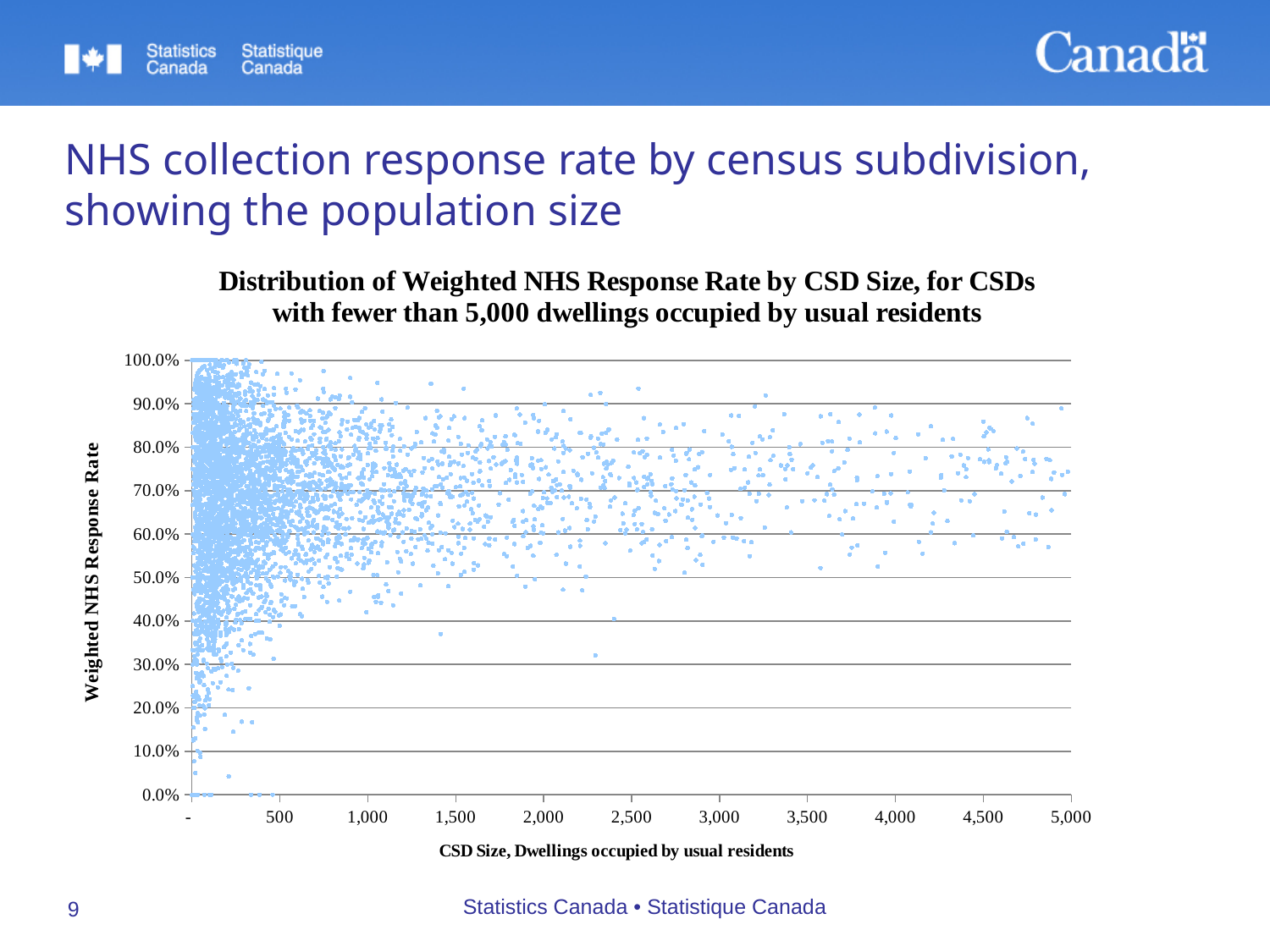
What is the title of the chart? Distribution of Weighted NHS Response Rate by CSD Size, for CSDs with fewer than 5,000 dwellings occupied by usual residents For CSDs with more than 3,000 dwellings, are most of the plotted response rates greater or less than 50.0%? greater Are the points with response rates below 30.0% mostly found at CSD sizes less than or greater than 1,000 dwellings? less What is the label of the vertical axis of the chart? Weighted NHS Response Rate For CSDs with more than 2,500 dwellings, are most of the plotted response rates greater or less than 40.0%? greater As CSD size increases along the x axis, does the vertical spread of the points become wider or narrower? narrower What kind of chart is shown on the slide? scatter chart